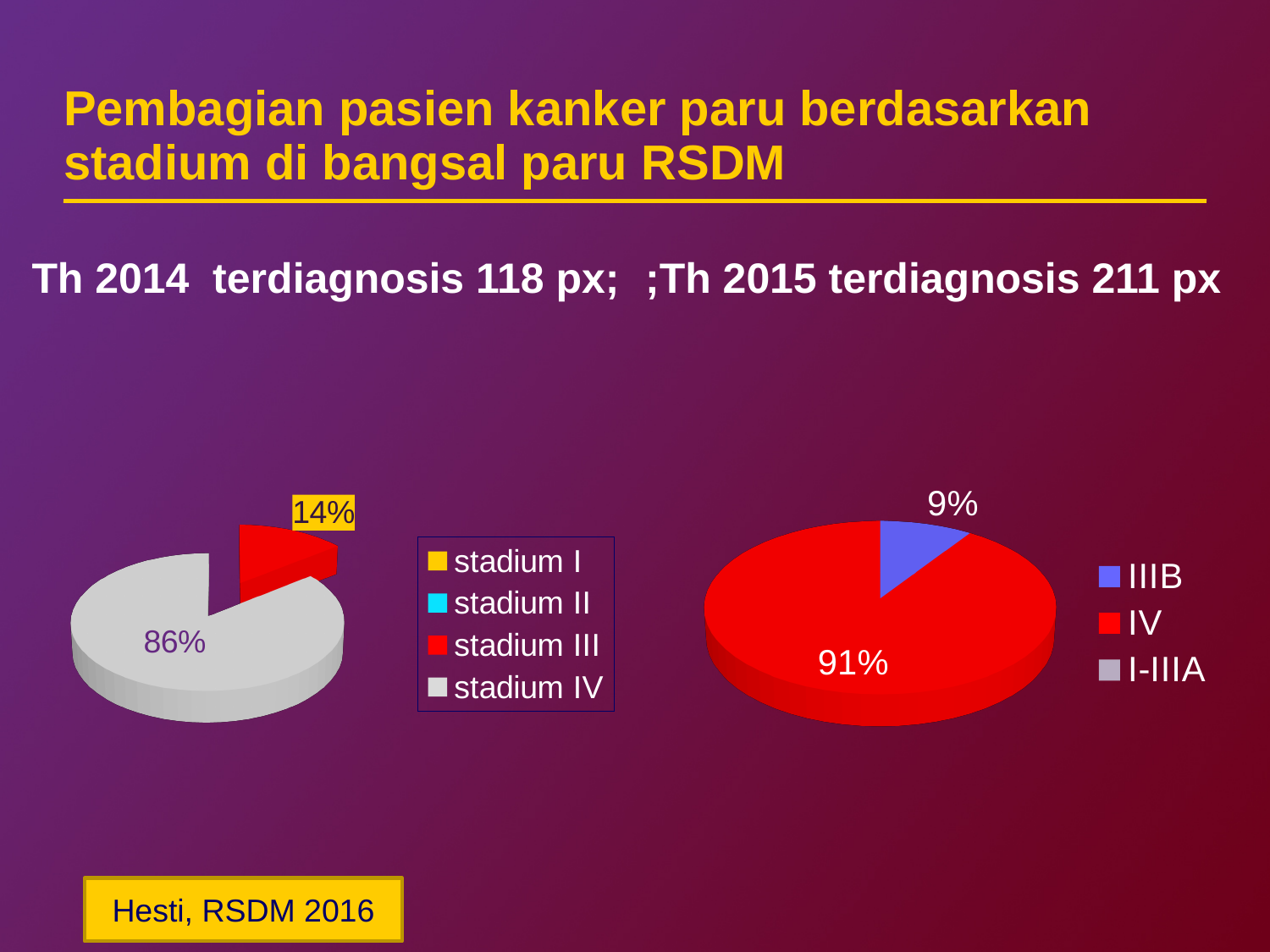
In the right pie chart, what percentage is shown for IIIB? 9% In the right pie chart, which is larger, IIIB or IV? IV What type of chart is used on the left side of the slide? Pie chart In the right pie chart, what is the difference in percentage points between IV and IIIB? 82 percentage points In the left pie chart, what is the difference in percentage points between stadium IV and stadium III? 72 percentage points In the left pie chart, which category has the largest slice? stadium IV How many entries does the legend of the left pie chart list? 4 How many entries does the legend of the right pie chart list? 3 In the left pie chart, what percentage is shown for stadium III? 14% In the right pie chart, which category has the largest slice? IV In the right pie chart, what percentage is shown for IV? 91%